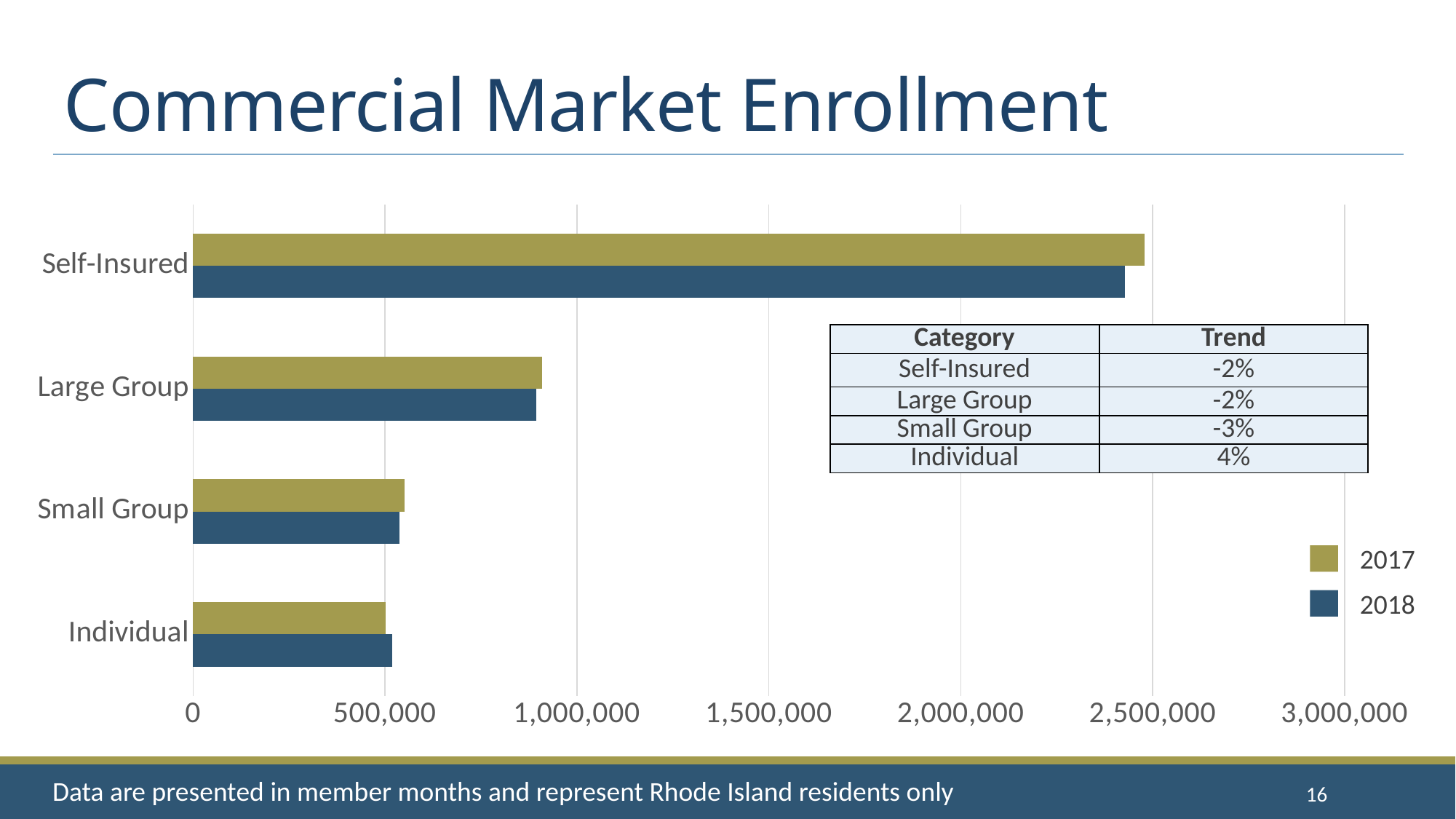
Which category has the highest enrollment in 2017? Self-Insured Which category has the lowest enrollment in 2017? Individual According to the table on the slide, what is the trend for Individual? 4% For Self-Insured, which year has the larger value, 2017 or 2018? 2017 According to the table on the slide, what is the trend for Small Group? -3% How many categories are plotted on the chart? 4 Is the 2018 value for Self-Insured greater or less than 2,500,000? less How many series does the legend list? 2 For Large Group, which year has the larger value, 2017 or 2018? 2017 Is the 2017 value for Large Group greater or less than 1,000,000? less What kind of chart is shown on the slide? bar chart Is the 2017 value for Small Group greater or less than 500,000? greater